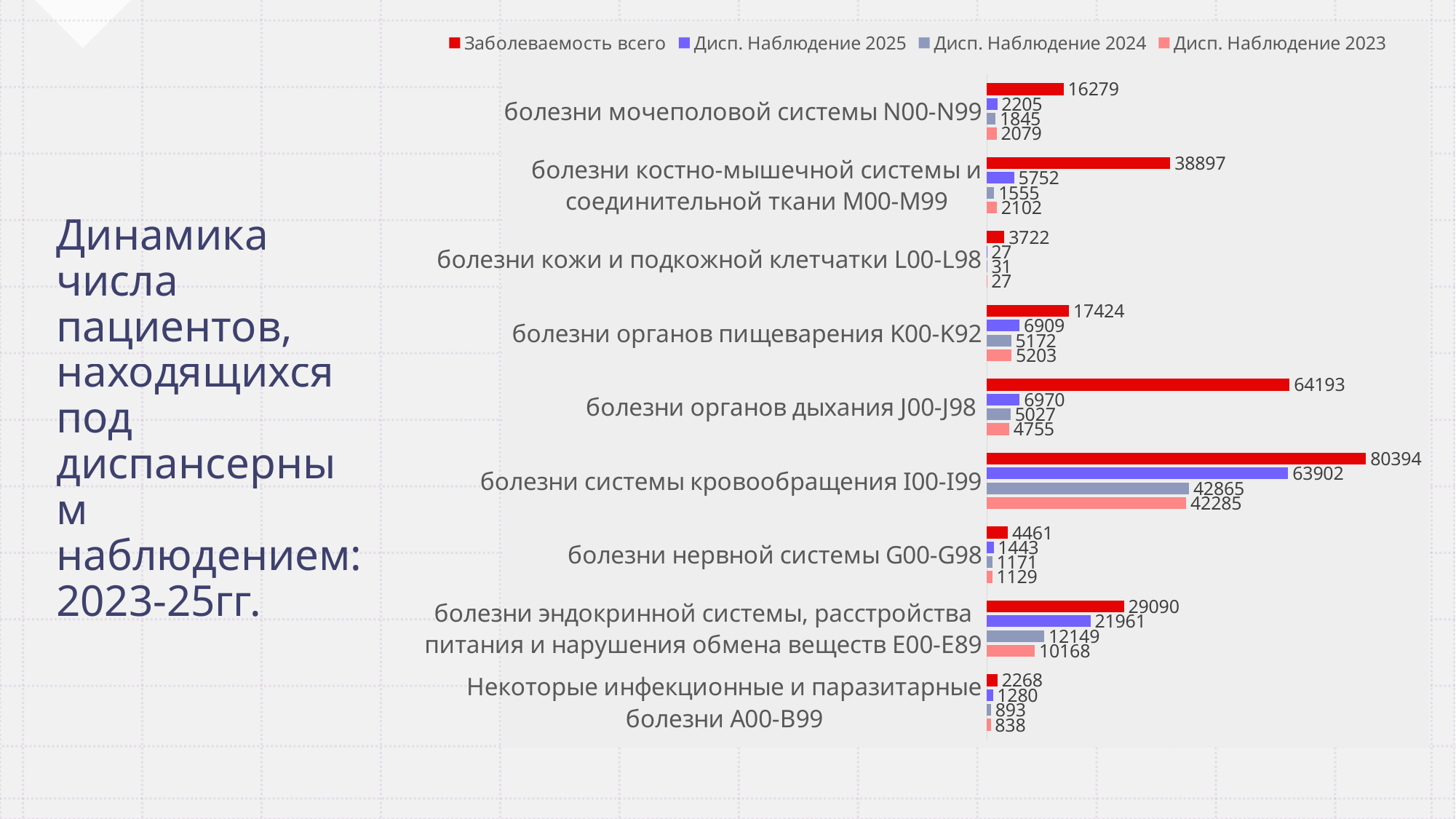
What type of chart is shown on the slide? Bar chart What is the value of Дисп. Наблюдение 2024 for болезни кожи и подкожной клетчатки L00-L98? 31 What is the value of Заболеваемость всего for болезни системы кровообращения I00-I99? 80394 What is the value of Дисп. Наблюдение 2023 for болезни эндокринной системы, расстройства питания и нарушения обмена веществ E00-E89? 10168 What is the difference between Дисп. Наблюдение 2025 and Дисп. Наблюдение 2024 for болезни системы кровообращения I00-I99? 21037 What is the value of Дисп. Наблюдение 2025 for болезни органов пищеварения K00-K92? 6909 Which category has the highest value for Заболеваемость всего? болезни системы кровообращения I00-I99 Which is larger for болезни органов дыхания J00-J98: Дисп. Наблюдение 2025 or Дисп. Наблюдение 2023? Дисп. Наблюдение 2025 What colour are the bars for the Заболеваемость всего series? Red How many series does the legend list? 4 Which category has the lowest value for Дисп. Наблюдение 2025? болезни кожи и подкожной клетчатки L00-L98 How many disease categories are plotted on the chart? 9